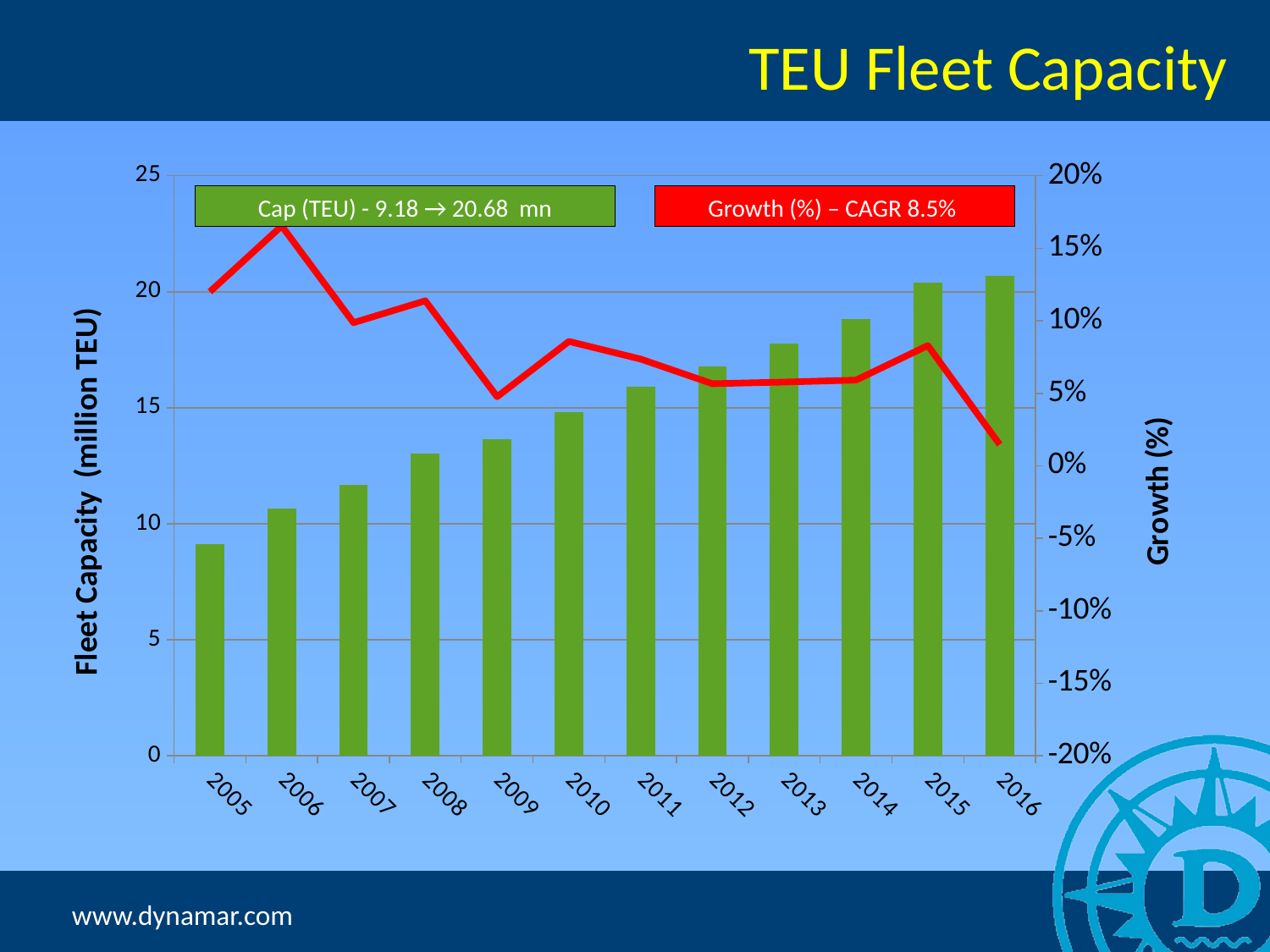
In which year does the growth (%) line reach its highest point? 2006 Is the fleet capacity for 2016 greater or less than 20 million TEU? greater Which year has the lowest fleet capacity bar? 2005 Is the growth value for 2006 greater or less than 15%? greater What kind of chart is shown on the slide? A combined bar and line chart How many years are shown along the x axis? 12 Do the fleet capacity bars rise or fall from 2005 to 2016? rise What CAGR does the red growth legend box state? 8.5% Which year has the highest fleet capacity bar? 2016 How many series does the legend list? 2 Is the fleet capacity for 2005 greater or less than 10 million TEU? less In which year does the growth (%) line reach its lowest point? 2016